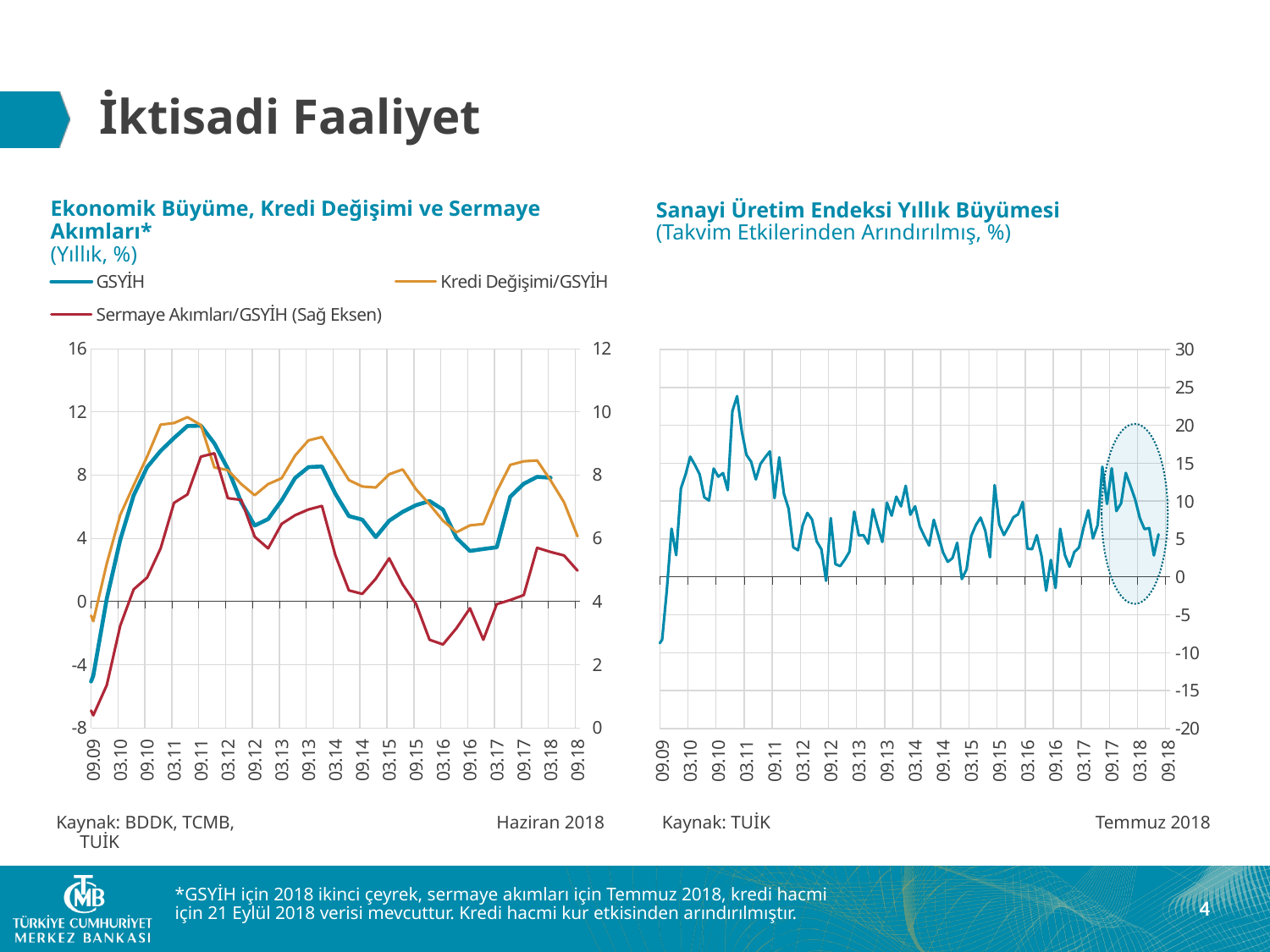
In the right chart, 'Sanayi Üretim Endeksi Yıllık Büyümesi', is the peak value around 03.11 greater or less than 20? greater In the left chart, 'Ekonomik Büyüme, Kredi Değişimi ve Sermaye Akımları*', which series is plotted on the right axis according to the legend? Sermaye Akımları/GSYİH (Sağ Eksen) In the left chart, 'Ekonomik Büyüme, Kredi Değişimi ve Sermaye Akımları*', is the GSYİH value larger at 09.09 or at 09.11? 09.11 How many series does the legend of the left chart, 'Ekonomik Büyüme, Kredi Değişimi ve Sermaye Akımları*', list? 3 In the right chart, 'Sanayi Üretim Endeksi Yıllık Büyümesi', is the value at 09.09 greater or less than -5? less In the left chart, 'Ekonomik Büyüme, Kredi Değişimi ve Sermaye Akımları*', does the GSYİH series rise or fall between 09.09 and 09.11? Rise What is the source (Kaynak) given below the right chart, 'Sanayi Üretim Endeksi Yıllık Büyümesi'? TUİK What kind of chart is the left chart, 'Ekonomik Büyüme, Kredi Değişimi ve Sermaye Akımları*'? Line chart In the right chart, 'Sanayi Üretim Endeksi Yıllık Büyümesi', does the series rise or fall between 09.09 and 03.11? Rise What kind of chart is the right chart, 'Sanayi Üretim Endeksi Yıllık Büyümesi'? Line chart In the left chart, 'Ekonomik Büyüme, Kredi Değişimi ve Sermaye Akımları*', is the GSYİH value at 09.09 greater or less than 0? less